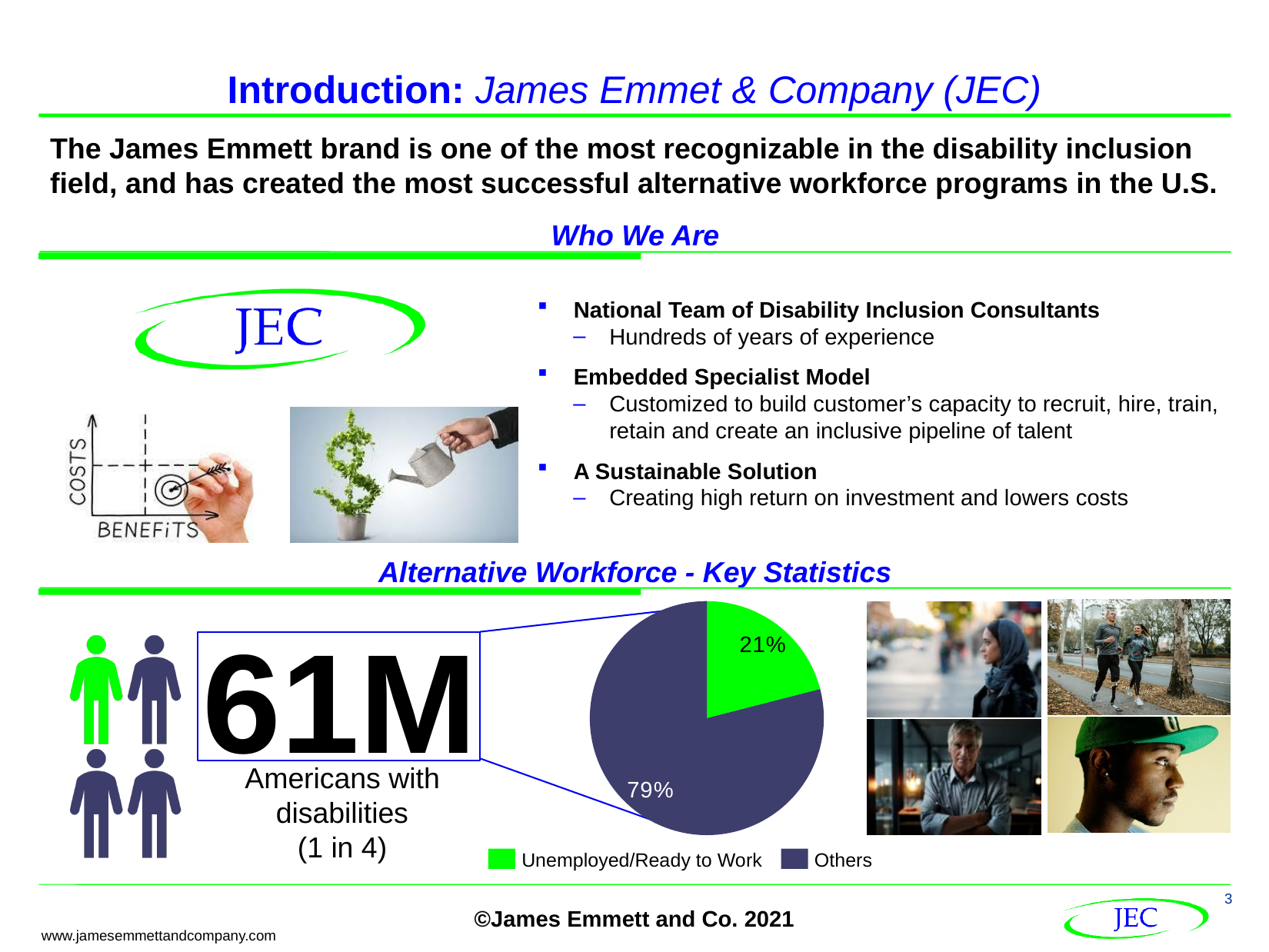
How many entries does the pie chart's legend list? 2 How many slices does the pie chart have? 2 What is the difference in percentage points between the Others slice and the Unemployed/Ready to Work slice? 58 What colour is the Unemployed/Ready to Work slice in the pie chart? green What share of the pie chart is labelled Others? 79% What colour is the Others slice in the pie chart? dark blue Which slice of the pie chart is the largest? Others What share of the pie chart is labelled Unemployed/Ready to Work? 21% Which slice of the pie chart is the smallest? Unemployed/Ready to Work What kind of chart is shown in the Alternative Workforce - Key Statistics section? pie chart Which is larger in the pie chart, Unemployed/Ready to Work or Others? Others Is the Unemployed/Ready to Work share of the pie chart greater or less than 50%? less